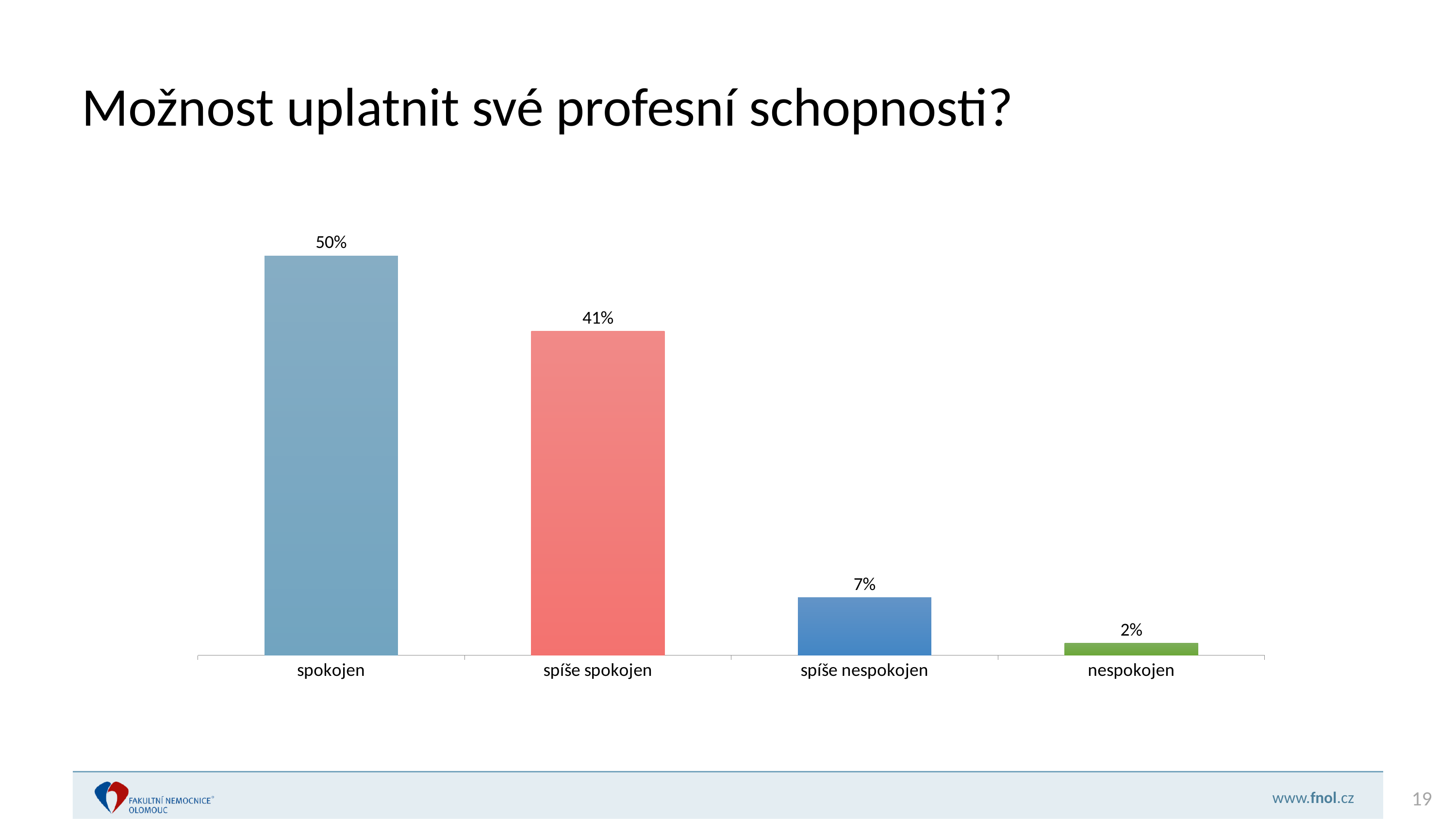
What is the difference between the values for "spokojen" and "spíše spokojen"? 9% What is the value for "spíše nespokojen"? 7% What is the difference between the values for "spíše nespokojen" and "nespokojen"? 5% What kind of chart is shown on the slide? bar chart What is the value for "spokojen"? 50% Which category has the lowest value? nespokojen What is the value for "nespokojen"? 2% What is the value for "spíše spokojen"? 41% Which category has the highest value? spokojen How many categories are shown on the chart? 4 Do the values rise or fall from left to right along the x axis? fall Which is larger, the value for "spíše spokojen" or the value for "spíše nespokojen"? spíše spokojen